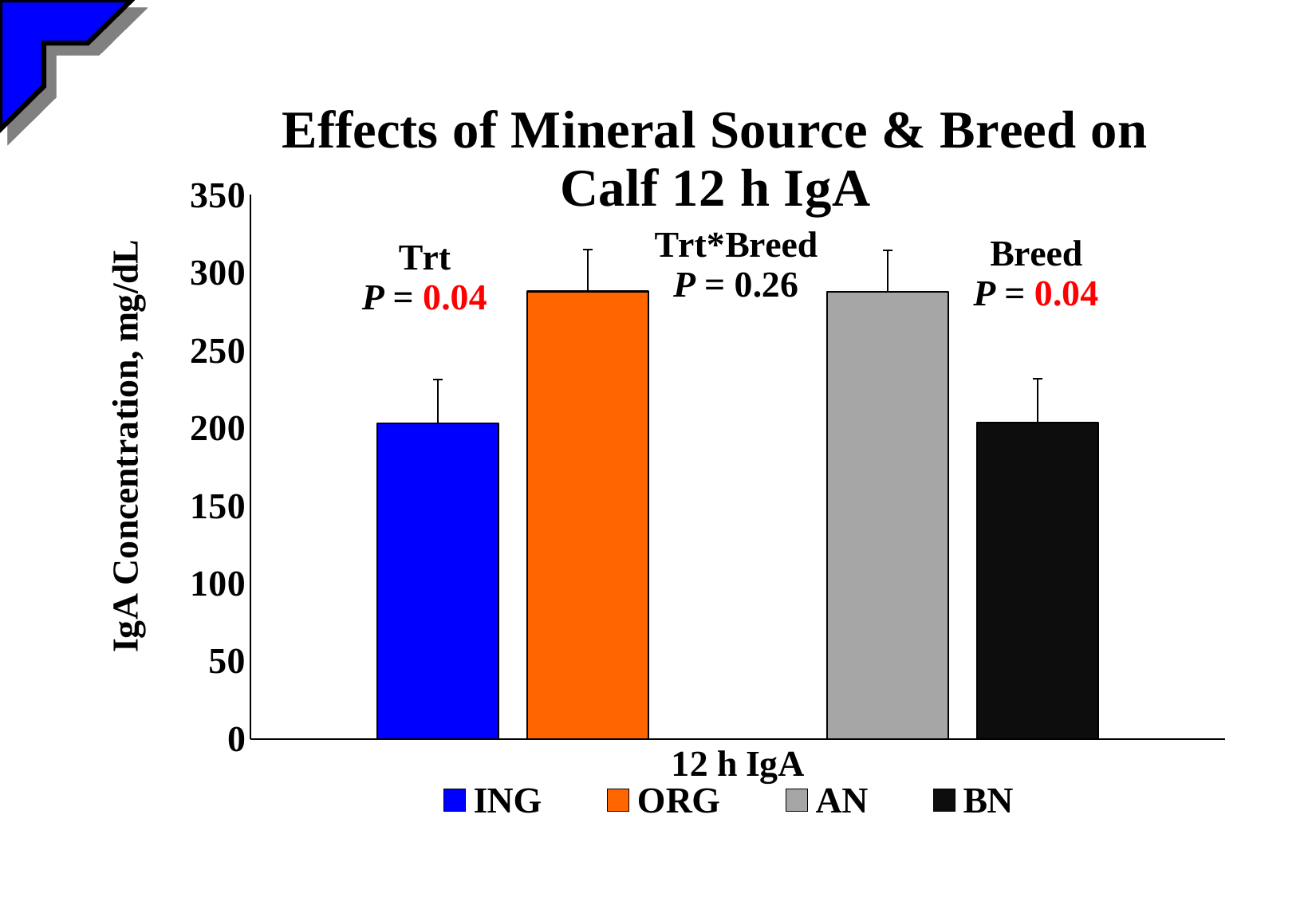
Is the value for BN greater or less than 250? less Which is larger, the value for ORG or the value for ING? ORG How many series does the legend list? 4 What is the title of the chart? Effects of Mineral Source & Breed on Calf 12 h IgA Is the value for ING greater or less than 250? less Is the value for AN greater or less than 250? greater Which is larger, the value for AN or the value for BN? AN What is the label on the vertical axis? IgA Concentration, mg/dL What kind of chart is shown on the slide? bar chart